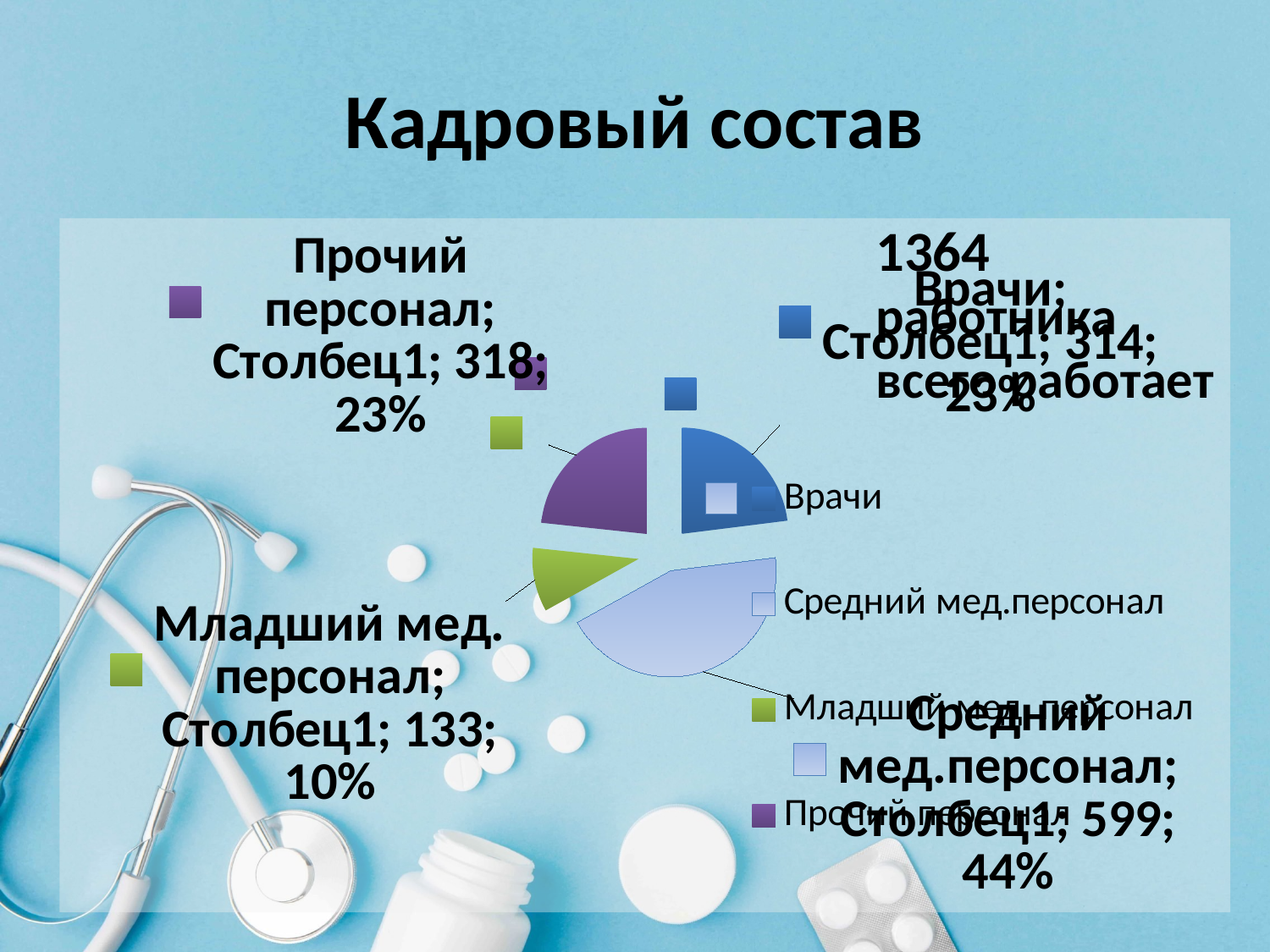
How many categories does the pie chart have? 4 What kind of chart is shown on the slide? pie chart What is the value for Прочий персонал? 318 Which category has the largest slice of the pie? Средний мед.персонал What share of the pie does Младший мед. персонал represent? 10% What is the value for Врачи? 314 What is the value for Средний мед.персонал? 599 What is the value for Младший мед. персонал? 133 What is the difference between the values for Средний мед.персонал and Младший мед. персонал? 466 Which category has the smallest slice of the pie? Младший мед. персонал What is the title of the slide containing the pie chart? Кадровый состав What share of the pie does Средний мед.персонал represent? 44%